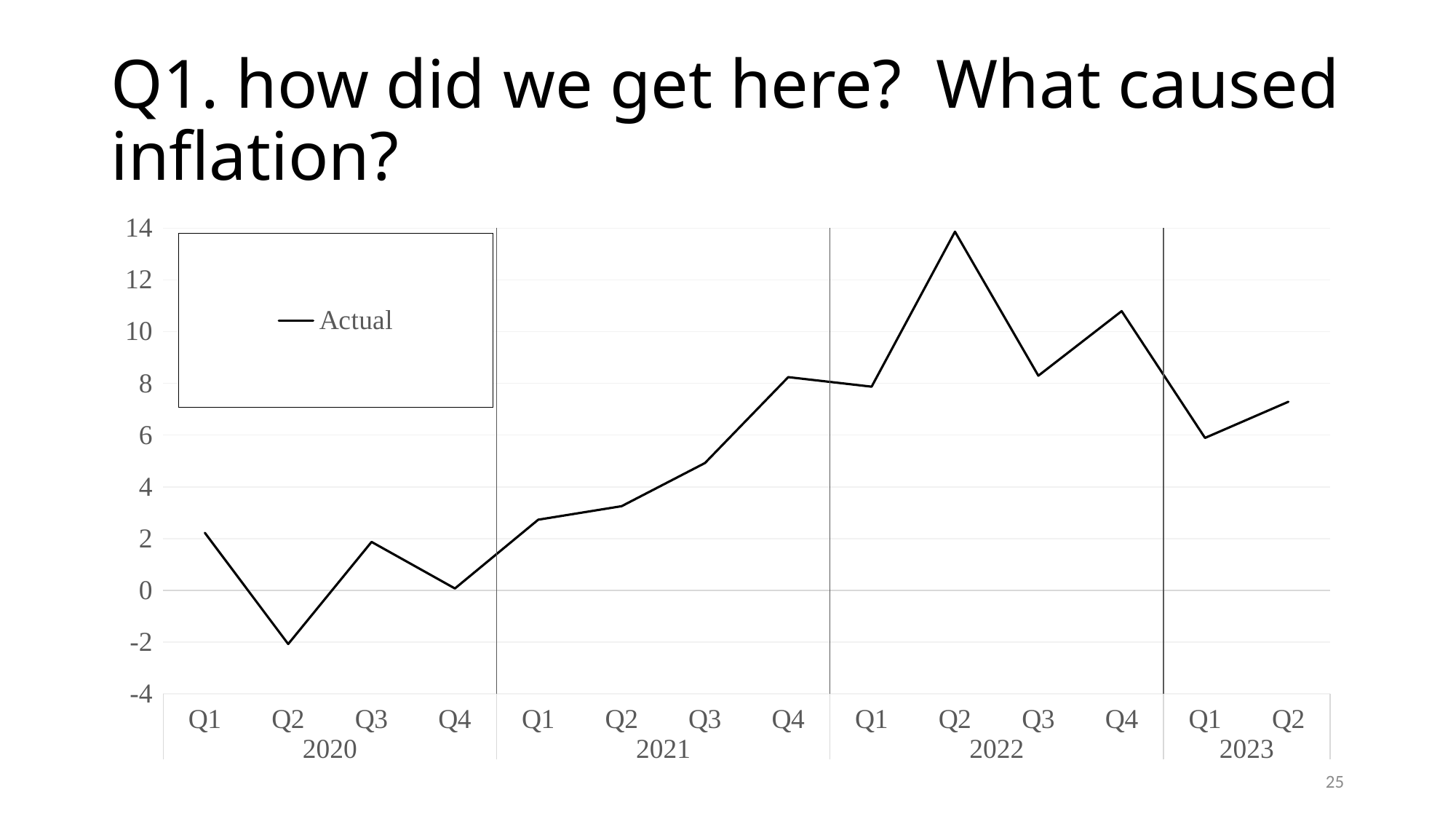
Which is larger, the value for Q2 2022 or the value for Q4 2022? Q2 2022 What kind of chart is shown on the slide? line chart How many series does the legend list? 1 Does the Actual line rise or fall from Q4 2020 to Q4 2021? rise What is the name of the series shown in the legend? Actual How many quarterly data points are plotted on the chart? 14 In which quarter does the Actual line reach its highest value? Q2 2022 Is the value for Q4 2022 greater or less than 10? greater Is the value for Q2 2020 greater or less than 0? less Is the value for Q2 2022 greater or less than 12? greater In which quarter does the Actual line reach its lowest value? Q2 2020